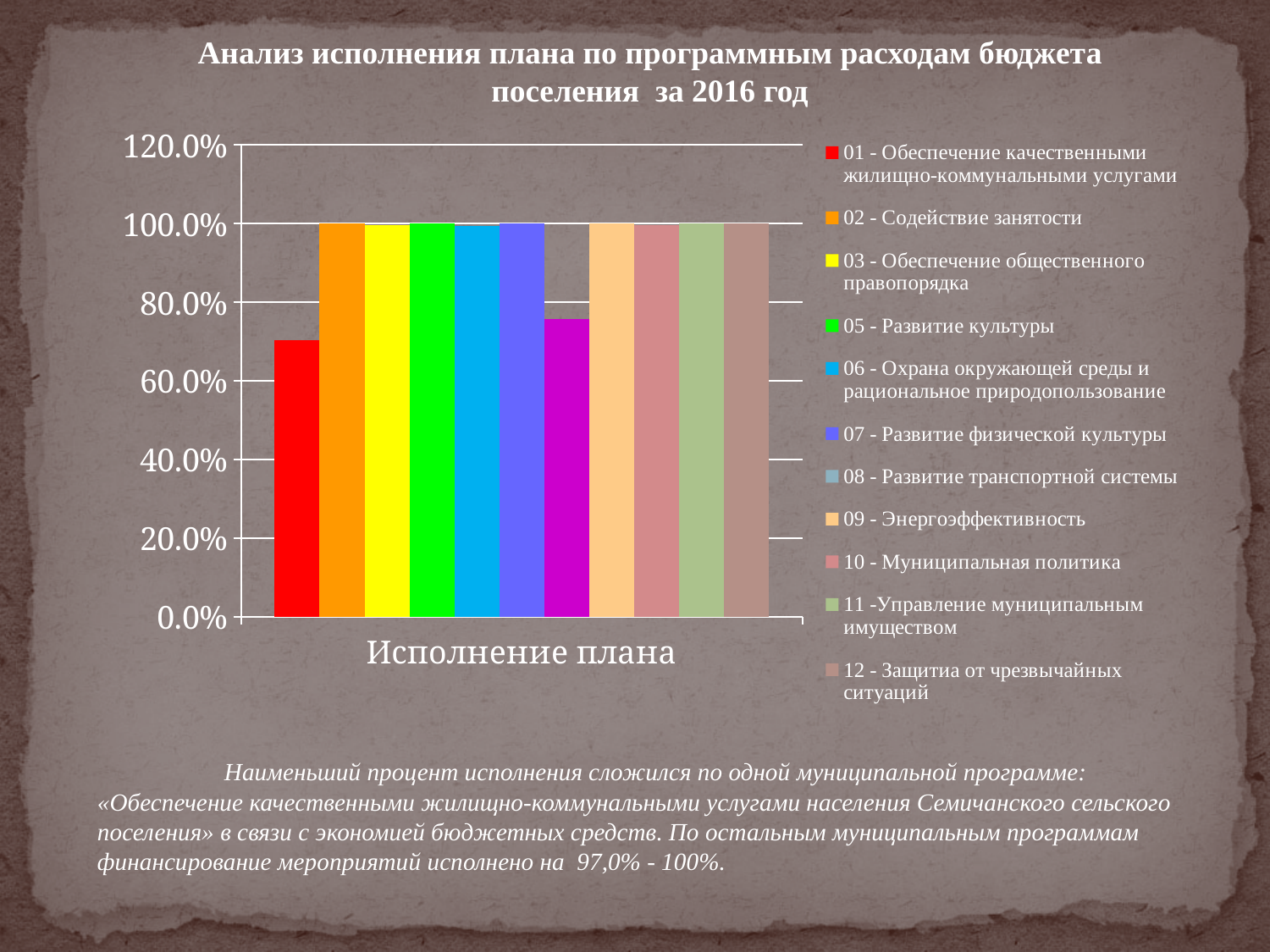
How many series does the legend list? 11 Which is larger: the value for "07 - Развитие физической культуры" or the value for "01 - Обеспечение качественными жилищно-коммунальными услугами"? 07 - Развитие физической культуры Is the value for "02 - Содействие занятости" greater or less than 80.0%? greater What colour is the bar for "01 - Обеспечение качественными жилищно-коммунальными услугами"? red Which is larger: the value for "02 - Содействие занятости" or the value for "01 - Обеспечение качественными жилищно-коммунальными услугами"? 02 - Содействие занятости What is the label shown on the x axis of the chart? Исполнение плана Is the value for "07 - Развитие физической культуры" greater or less than 60.0%? greater Which series has the lowest value in the chart? 01 - Обеспечение качественными жилищно-коммунальными услугами What kind of chart is shown on the slide? bar chart Is the value for "01 - Обеспечение качественными жилищно-коммунальными услугами" greater or less than 80.0%? less How many categories are shown on the x axis? 1